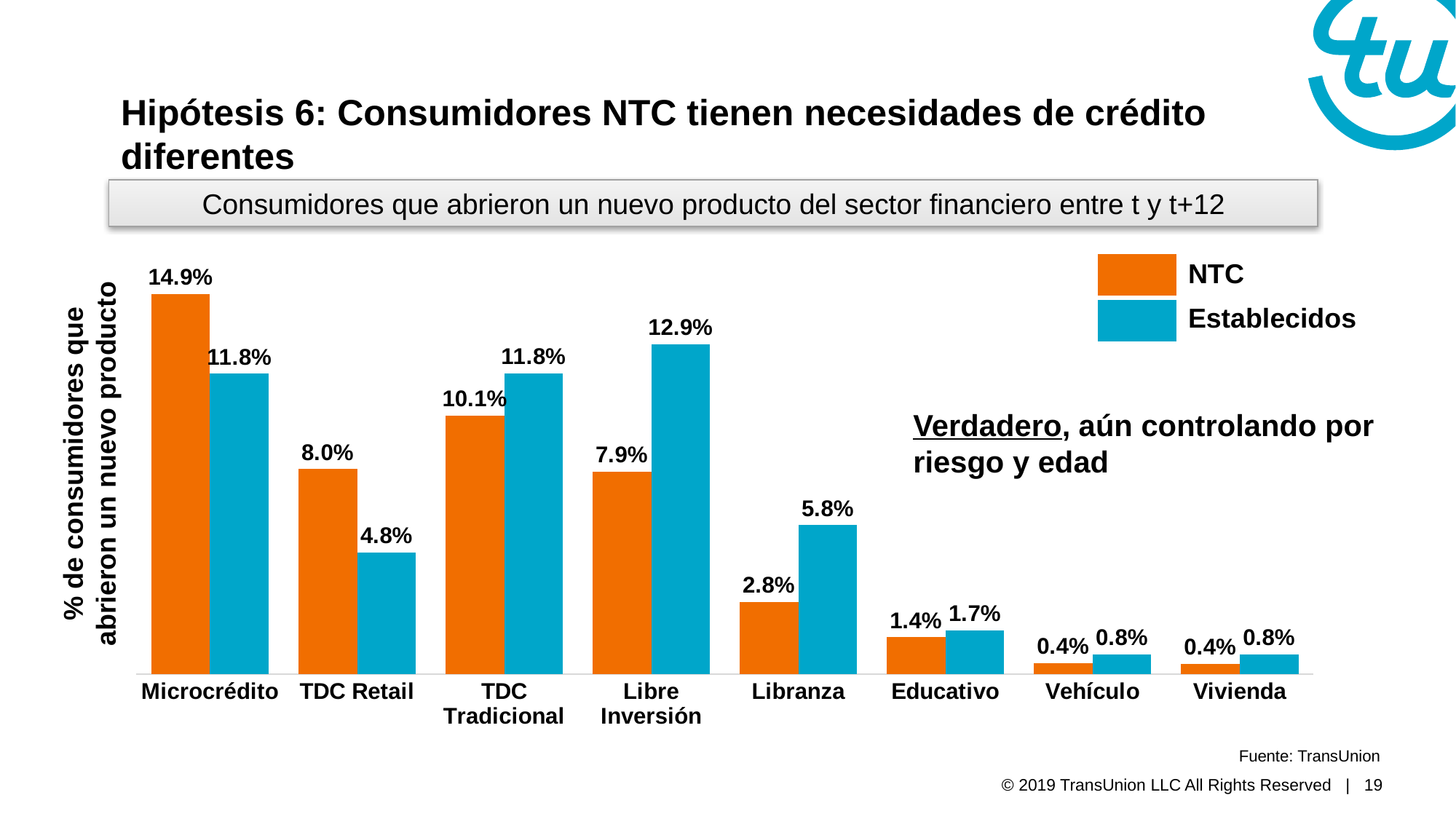
What is the difference between the NTC and Establecidos values for TDC Retail? 3.2% What is the difference between the Establecidos and NTC values for Libre Inversión? 5.0% How many series does the legend list? 2 For TDC Tradicional, which series has the larger value, NTC or Establecidos? Establecidos What is the NTC value for Libranza? 2.8% What type of chart is shown on the slide? Bar chart Which category has the highest NTC value? Microcrédito What is the NTC value for Microcrédito? 14.9% Which category has the highest Establecidos value? Libre Inversión For Microcrédito, which series has the larger value, NTC or Establecidos? NTC How many product categories are shown on the x axis? 8 What is the Establecidos value for Libre Inversión? 12.9%